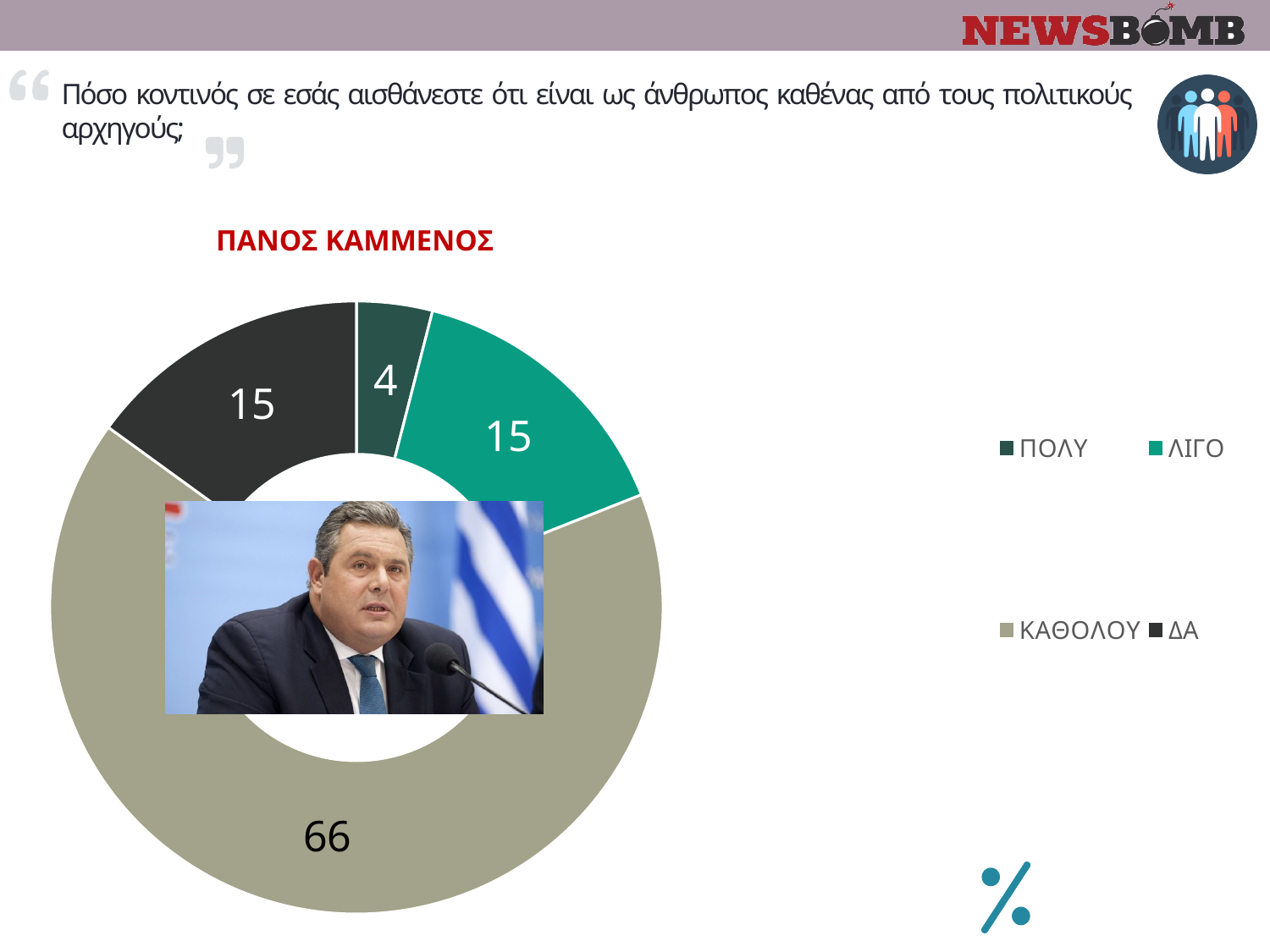
What is the value for ΠΟΛΥ in the ΠΑΝΟΣ ΚΑΜΜΕΝΟΣ chart? 4 What is the difference between the values for ΚΑΘΟΛΟΥ and ΛΙΓΟ in the ΠΑΝΟΣ ΚΑΜΜΕΝΟΣ chart? 51 What is the difference between the values for ΛΙΓΟ and ΠΟΛΥ in the ΠΑΝΟΣ ΚΑΜΜΕΝΟΣ chart? 11 Which category has the smallest slice in the ΠΑΝΟΣ ΚΑΜΜΕΝΟΣ chart? ΠΟΛΥ What is the value for ΔΑ in the ΠΑΝΟΣ ΚΑΜΜΕΝΟΣ chart? 15 What is the value for ΛΙΓΟ in the ΠΑΝΟΣ ΚΑΜΜΕΝΟΣ chart? 15 How many categories does the ΠΑΝΟΣ ΚΑΜΜΕΝΟΣ chart show? 4 What kind of chart is shown on the slide? Doughnut chart Which is larger in the ΠΑΝΟΣ ΚΑΜΜΕΝΟΣ chart, the value for ΚΑΘΟΛΟΥ or the value for ΔΑ? ΚΑΘΟΛΟΥ What is the title of the chart on the slide? ΠΑΝΟΣ ΚΑΜΜΕΝΟΣ Which category has the largest slice in the ΠΑΝΟΣ ΚΑΜΜΕΝΟΣ chart? ΚΑΘΟΛΟΥ What is the value for ΚΑΘΟΛΟΥ in the ΠΑΝΟΣ ΚΑΜΜΕΝΟΣ chart? 66